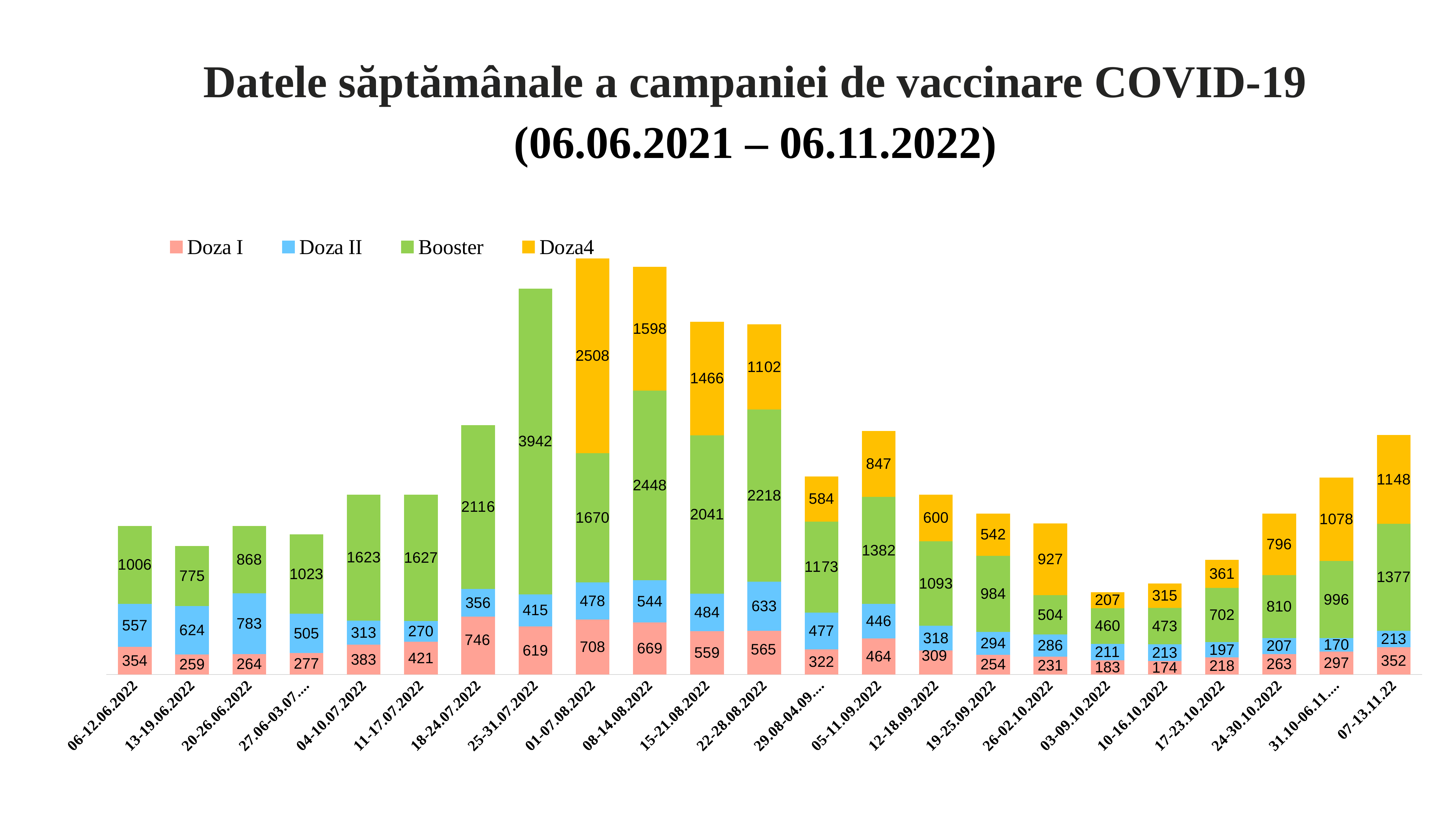
Which week has the highest Booster value? 25-31.07.2022 What type of chart is shown on the slide? Stacked bar chart What is the total of the stacked bar for the week 07-13.11.22? 3090 How many weekly periods (categories) are plotted on the x axis? 23 What is the Doza4 value for the week 01-07.08.2022? 2508 How many series does the legend list? 4 Which week has the larger Doza II value, 20-26.06.2022 or 13-19.06.2022? 20-26.06.2022 Which colour represents the Doza4 series in the legend? Orange/yellow Which week has the lowest Doza I value? 10-16.10.2022 What is the Booster value for the week 25-31.07.2022? 3942 What is the difference between the Doza4 values for 01-07.08.2022 and 08-14.08.2022? 910 What is the Doza I value for the week 18-24.07.2022? 746